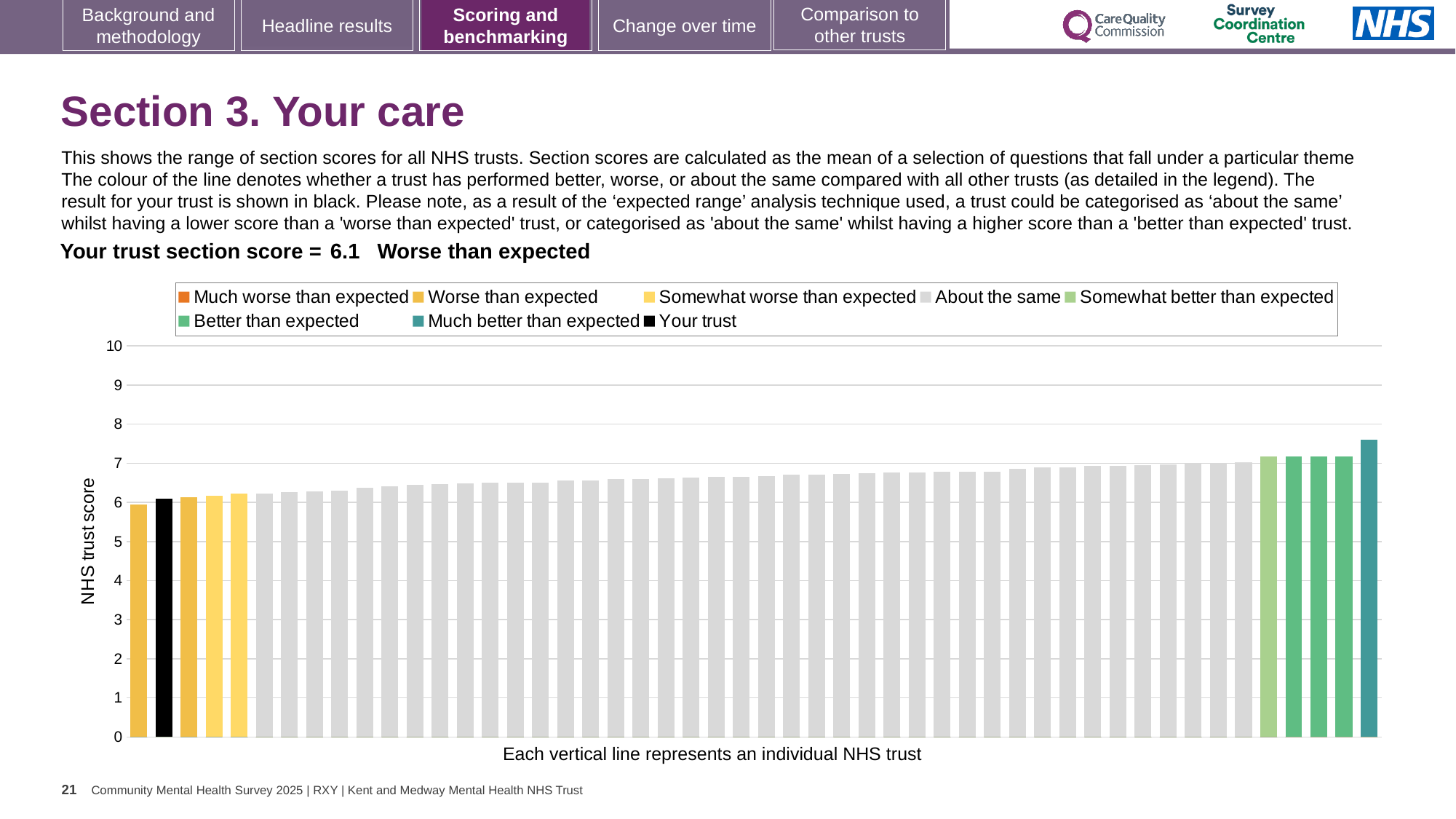
What is the section score for your trust? 6.1 What kind of chart is shown on the slide? bar chart Is the value for your trust greater or less than 5? greater Do the bar values rise or fall from left to right along the x axis? rise Is the value for your trust greater or less than 7? less Is the value of the tallest bar greater or less than 7? greater How many entries does the chart legend list? 8 What colour is the bar for your trust? black How many bars are coloured as 'Much better than expected'? 1 What is the title of the vertical axis? NHS trust score Which legend category does the tallest bar belong to? Much better than expected Which legend category does your trust fall into? Worse than expected